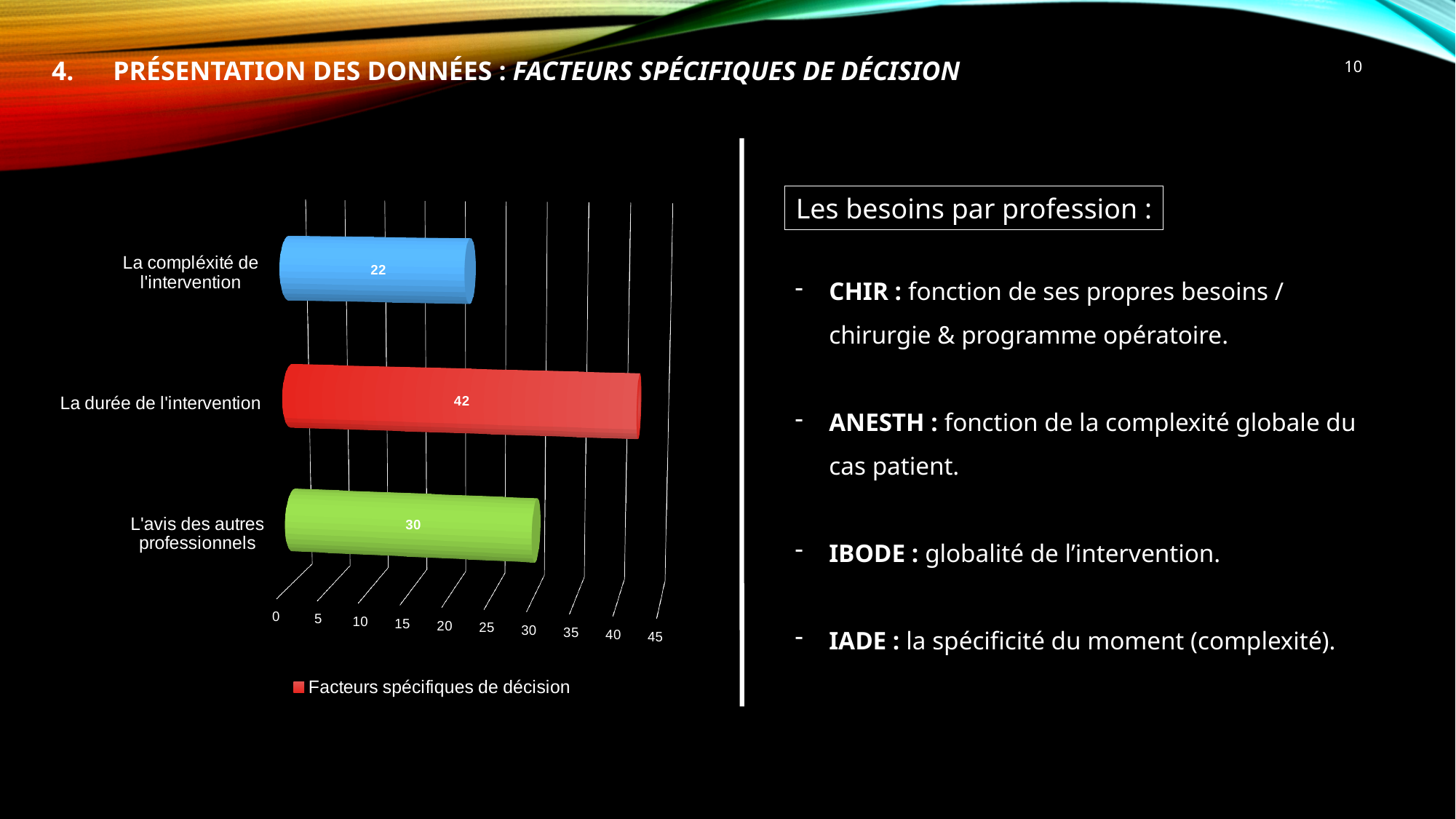
What series name does the chart legend show? Facteurs spécifiques de décision What is the difference between the values for "La durée de l'intervention" and "La compléxité de l'intervention"? 20 What is the value for "L'avis des autres professionnels"? 30 What is the value for "La durée de l'intervention"? 42 What kind of chart is shown on the slide? Bar chart What is the difference between the values for "L'avis des autres professionnels" and "La compléxité de l'intervention"? 8 How many categories are shown in the chart? 3 Is the value for "La durée de l'intervention" greater or less than 40? greater What is the value for "La compléxité de l'intervention"? 22 Which category has the highest value? La durée de l'intervention Which category has the lowest value? La compléxité de l'intervention Which is larger: the value for "L'avis des autres professionnels" or the value for "La compléxité de l'intervention"? L'avis des autres professionnels